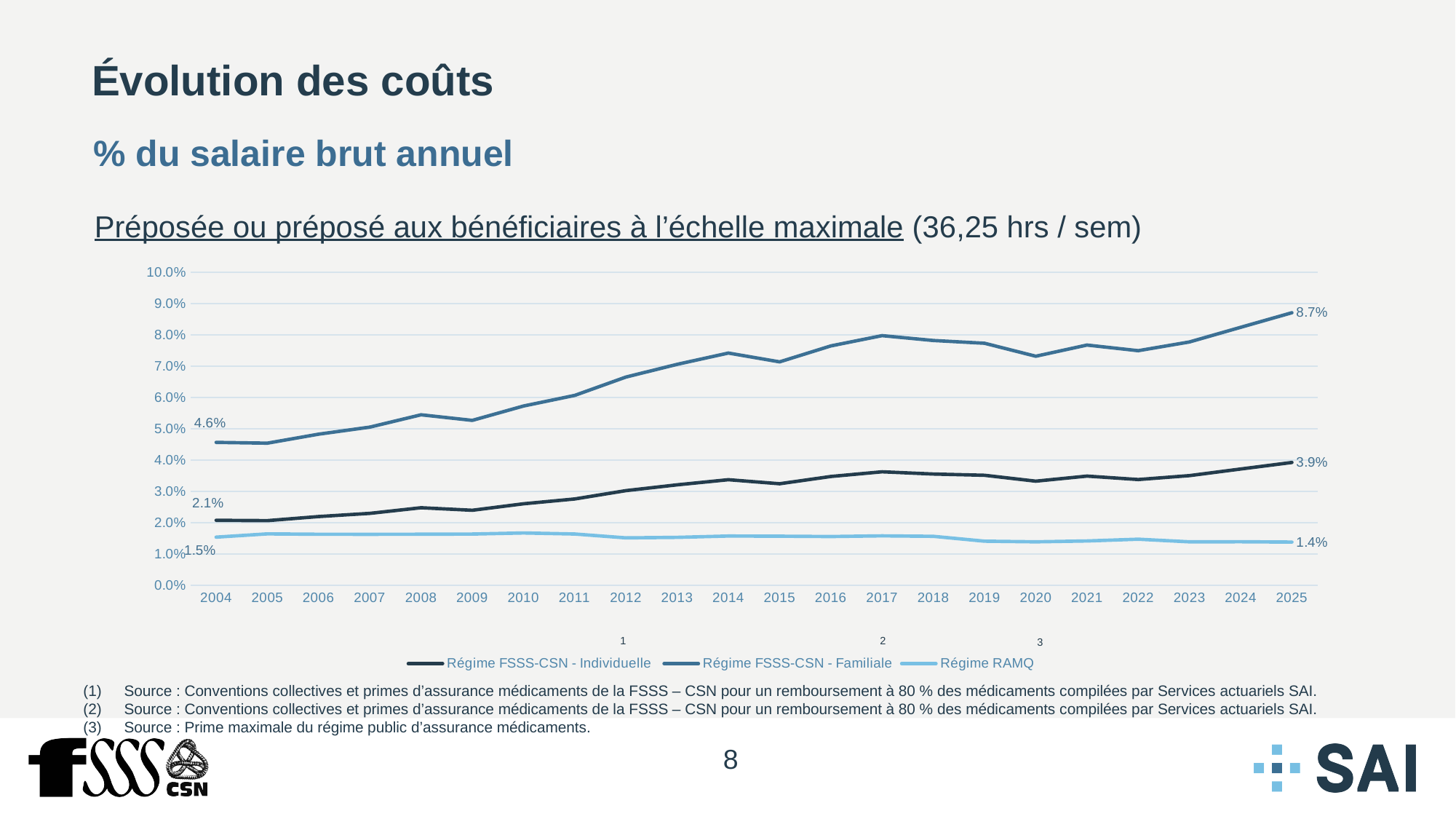
How many series does the legend list? 3 Which series has the lowest value in 2004? Régime RAMQ What is the value for Régime RAMQ in 2025? 1.4% Does the Régime FSSS-CSN - Familiale series generally rise or fall from 2004 to 2025? rise Which series has the highest value in 2025? Régime FSSS-CSN - Familiale How many years are shown on the x axis? 22 What is the value for Régime FSSS-CSN - Familiale in 2004? 4.6% What is the value for Régime FSSS-CSN - Individuelle in 2004? 2.1% What kind of chart is shown on the slide? line chart What is the value for Régime FSSS-CSN - Familiale in 2025? 8.7% Is the value for Régime FSSS-CSN - Familiale in 2017 greater or less than 7.0%? greater By how much did the Régime FSSS-CSN - Familiale value change from 2004 to 2025? 4.1%